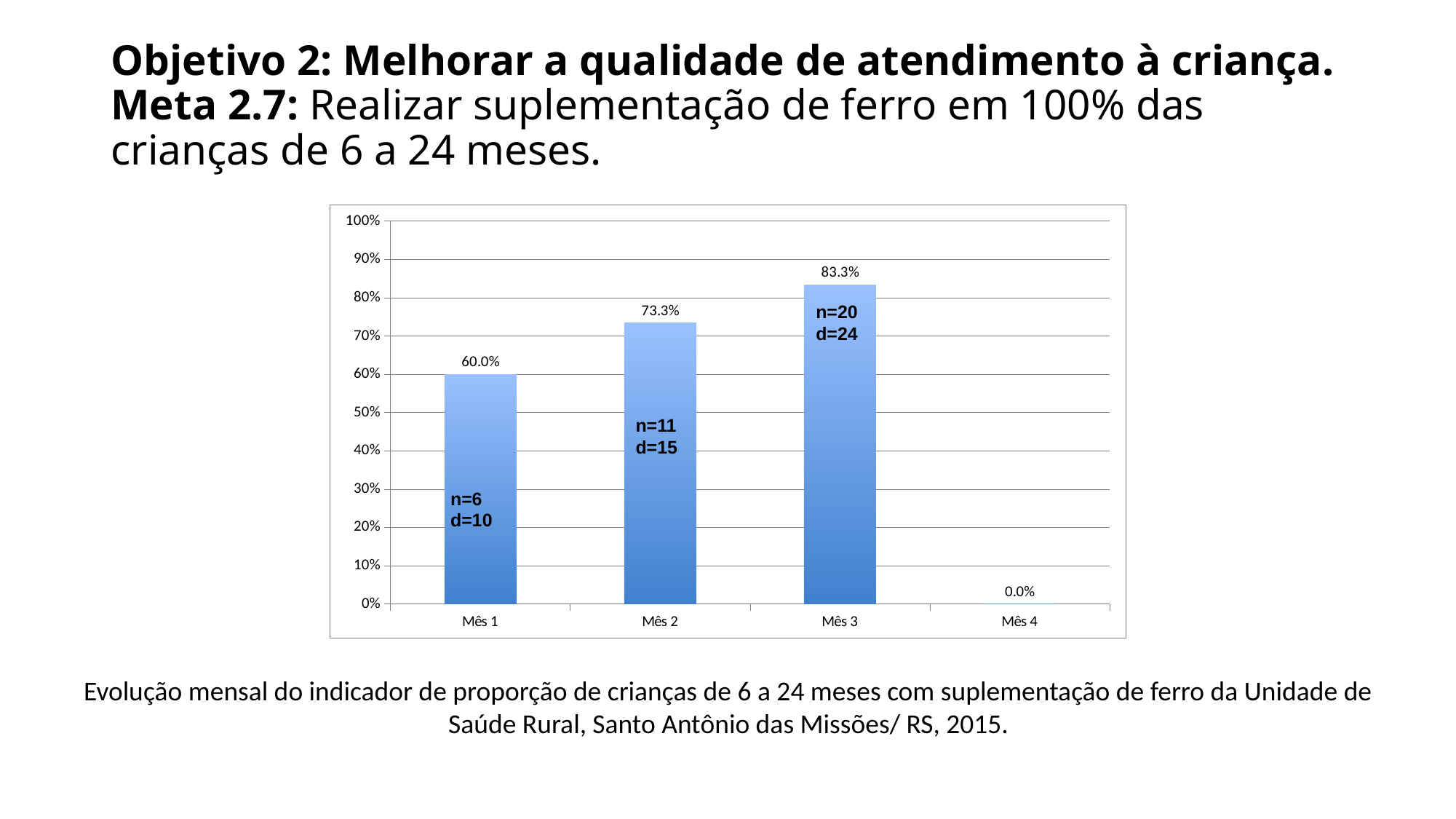
Do the values rise or fall from Mês 1 to Mês 3? Rise What kind of chart is shown on the slide? Bar chart What is the value for Mês 2? 73.3% What are the n and d values annotated on the bar for Mês 2? n=11, d=15 What is the difference between the values for Mês 3 and Mês 1? 23.3% What is the value for Mês 1? 60.0% Which month has the lowest value? Mês 4 Which month has the highest value? Mês 3 How many months are shown on the x axis? 4 What is the value for Mês 3? 83.3% Which is larger, the value for Mês 2 or the value for Mês 1? Mês 2 What is the value for Mês 4? 0.0%